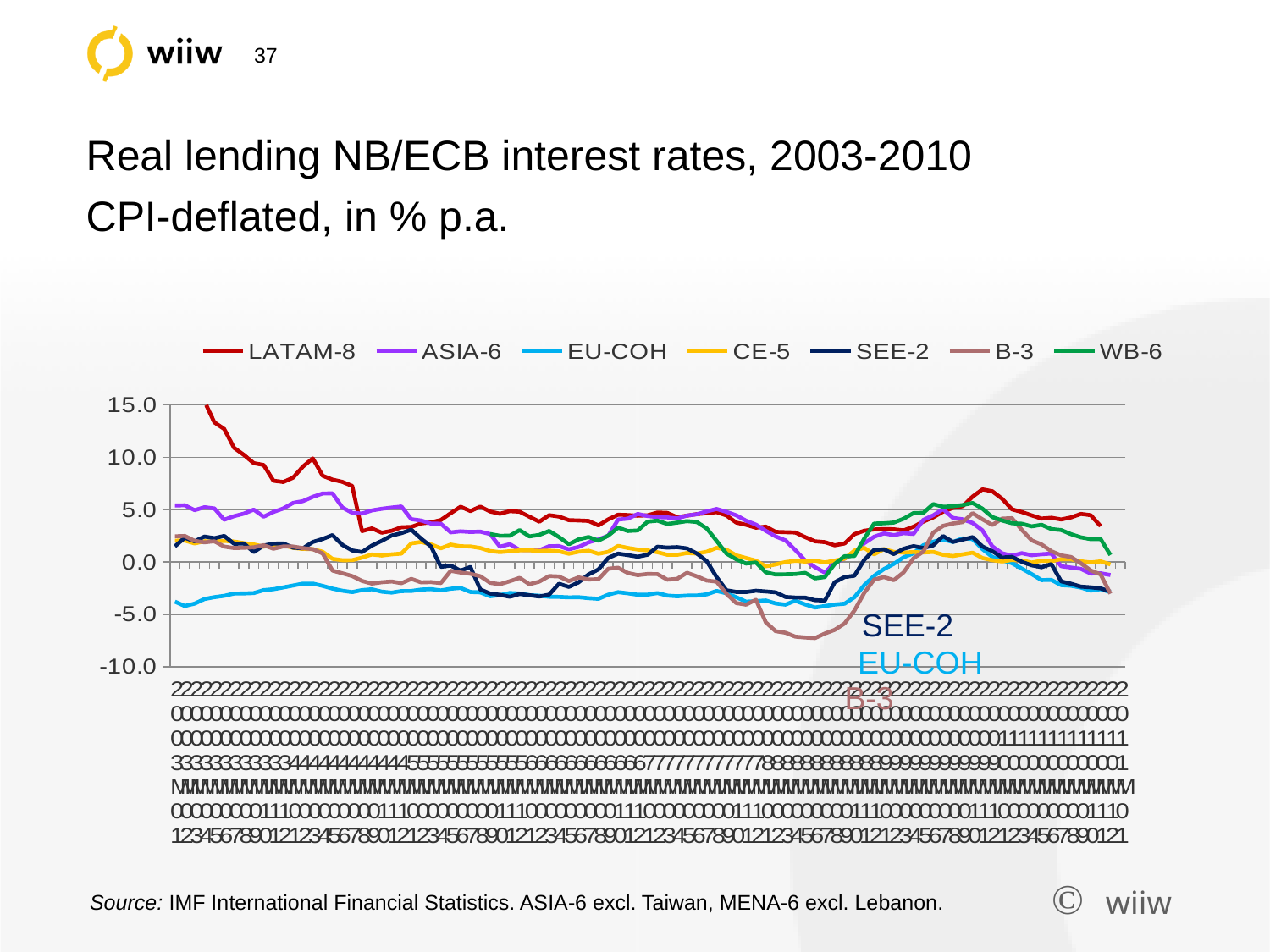
How many series does the legend list? 7 Is the value of EU-COH during 2004 greater or less than 0.0? less Which series has the highest value at the start of the period in 2003? LATAM-8 Is the lowest point of the B-3 line greater or less than -5.0? less Is the starting value of LATAM-8 in early 2003 greater or less than 10.0? greater Which series is listed first in the legend? LATAM-8 What colour is the EU-COH line? light blue What kind of chart is shown on the slide? line chart Which series reaches the lowest value on the chart, dipping below -5.0 around 2008-2009? B-3 Does the LATAM-8 line rise or fall over the course of 2003? fall In early 2003, which is larger, the value for LATAM-8 or the value for EU-COH? LATAM-8 What is the highest value shown on the vertical axis? 15.0